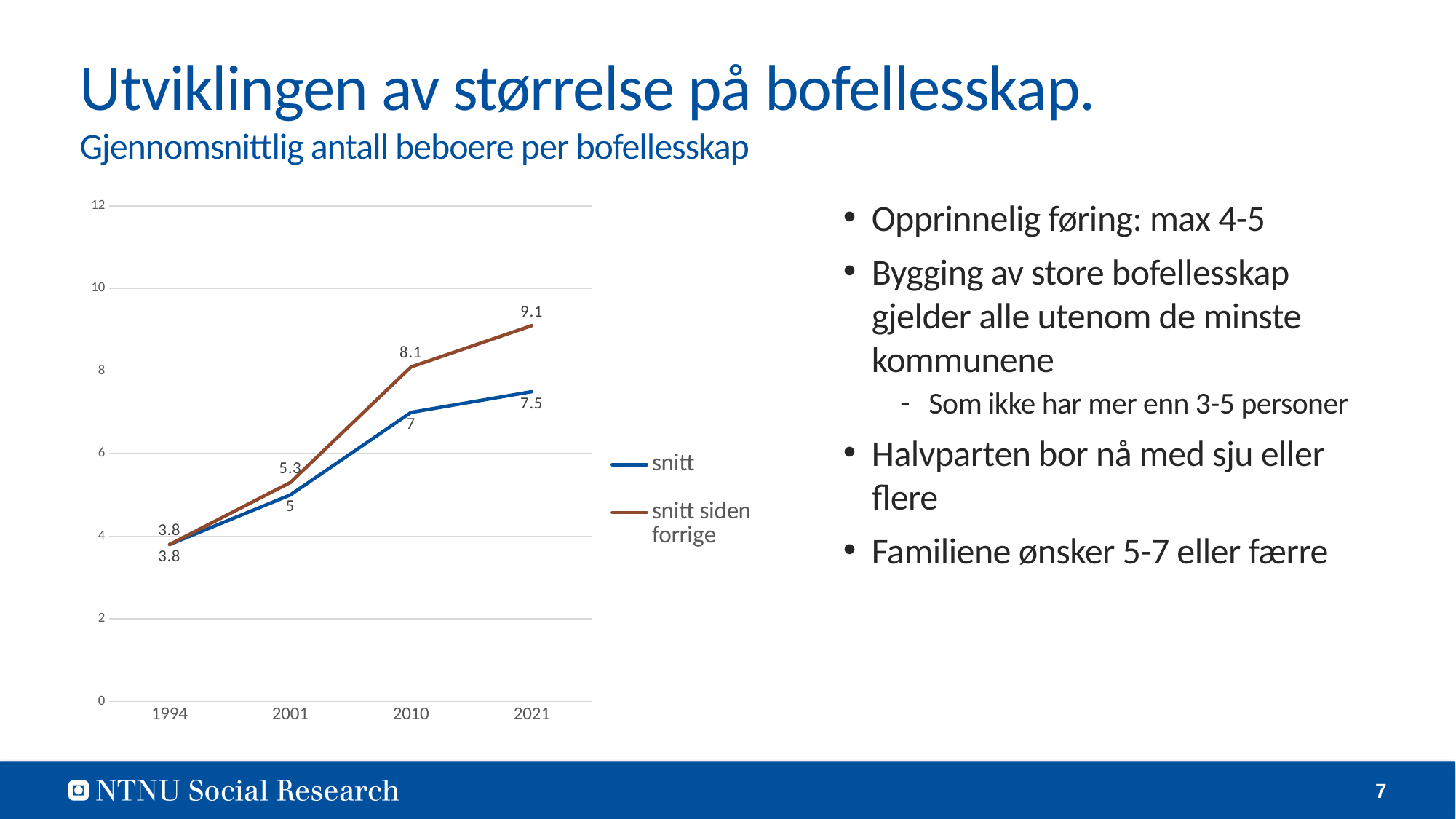
How many years are shown on the x axis? 4 In which year does the 'snitt siden forrige' series reach its highest value? 2021 How many series does the legend list? 2 What kind of chart is shown on the slide? line chart What is the difference between the 'snitt siden forrige' and 'snitt' values in 2021? 1.6 What is the value of the 'snitt' series in 2021? 7.5 Do the values of the 'snitt' series rise or fall from 1994 to 2021? rise What is the value of the 'snitt siden forrige' series in 2010? 8.1 What is the value of the 'snitt siden forrige' series in 2021? 9.1 In which year is the 'snitt' series at its lowest value? 1994 Which series has the higher value in 2010, 'snitt' or 'snitt siden forrige'? snitt siden forrige What is the value of the 'snitt' series in 2001? 5